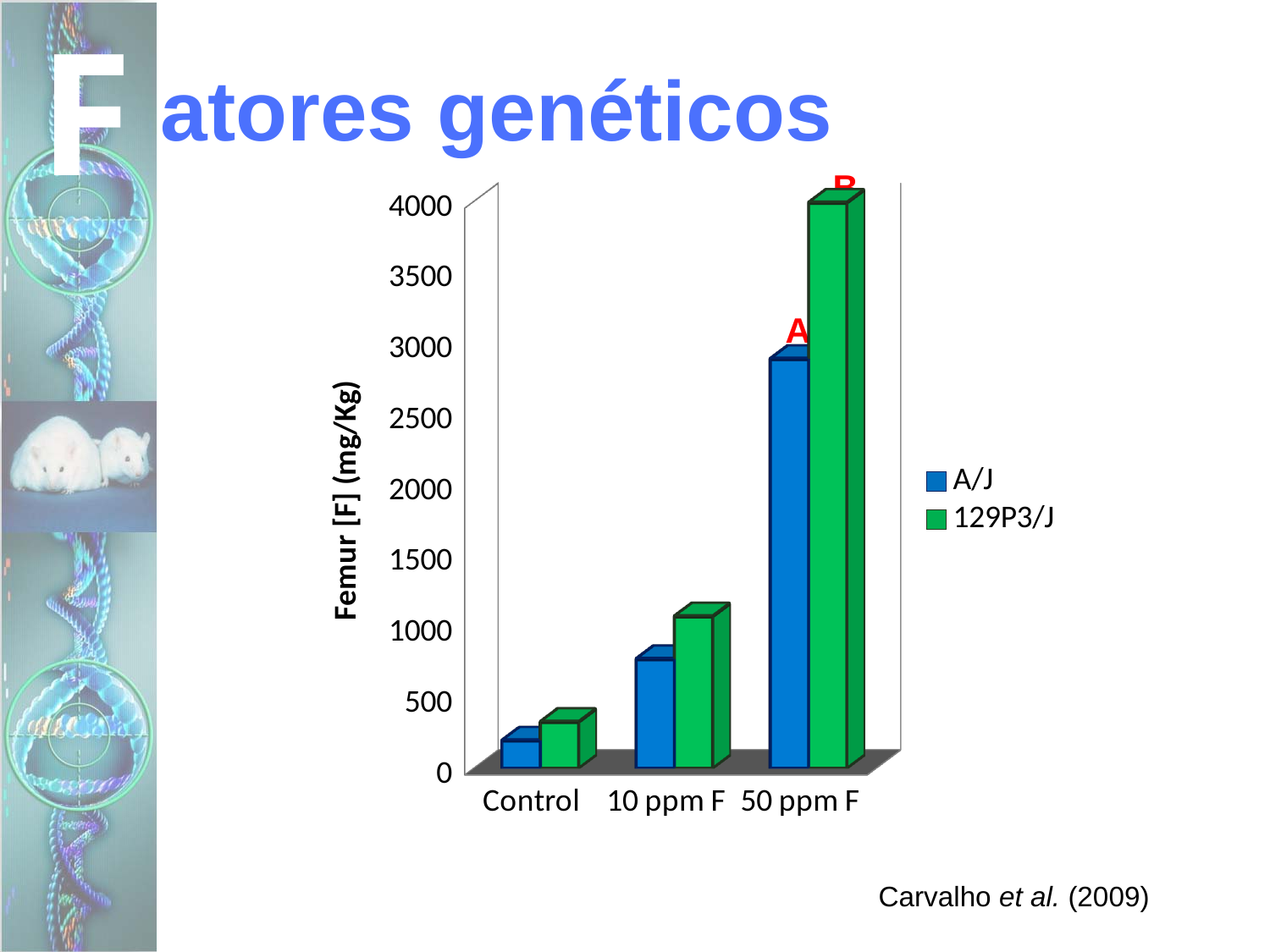
Which category has the lowest value for the 129P3/J series? Control What kind of chart is shown on the slide? bar chart At 50 ppm F, which series has the larger value, A/J or 129P3/J? 129P3/J How many series does the legend list? 2 Is the value for A/J at 50 ppm F greater or less than 2500? greater Which category has the highest value for the A/J series? 50 ppm F Is the value for 129P3/J at Control greater or less than 500? less Is the value for A/J at 10 ppm F greater or less than 1000? less What is the title of the y axis? Femur [F] (mg/Kg) Do the values for the 129P3/J series rise or fall from Control to 50 ppm F? rise How many categories are shown on the x axis? 3